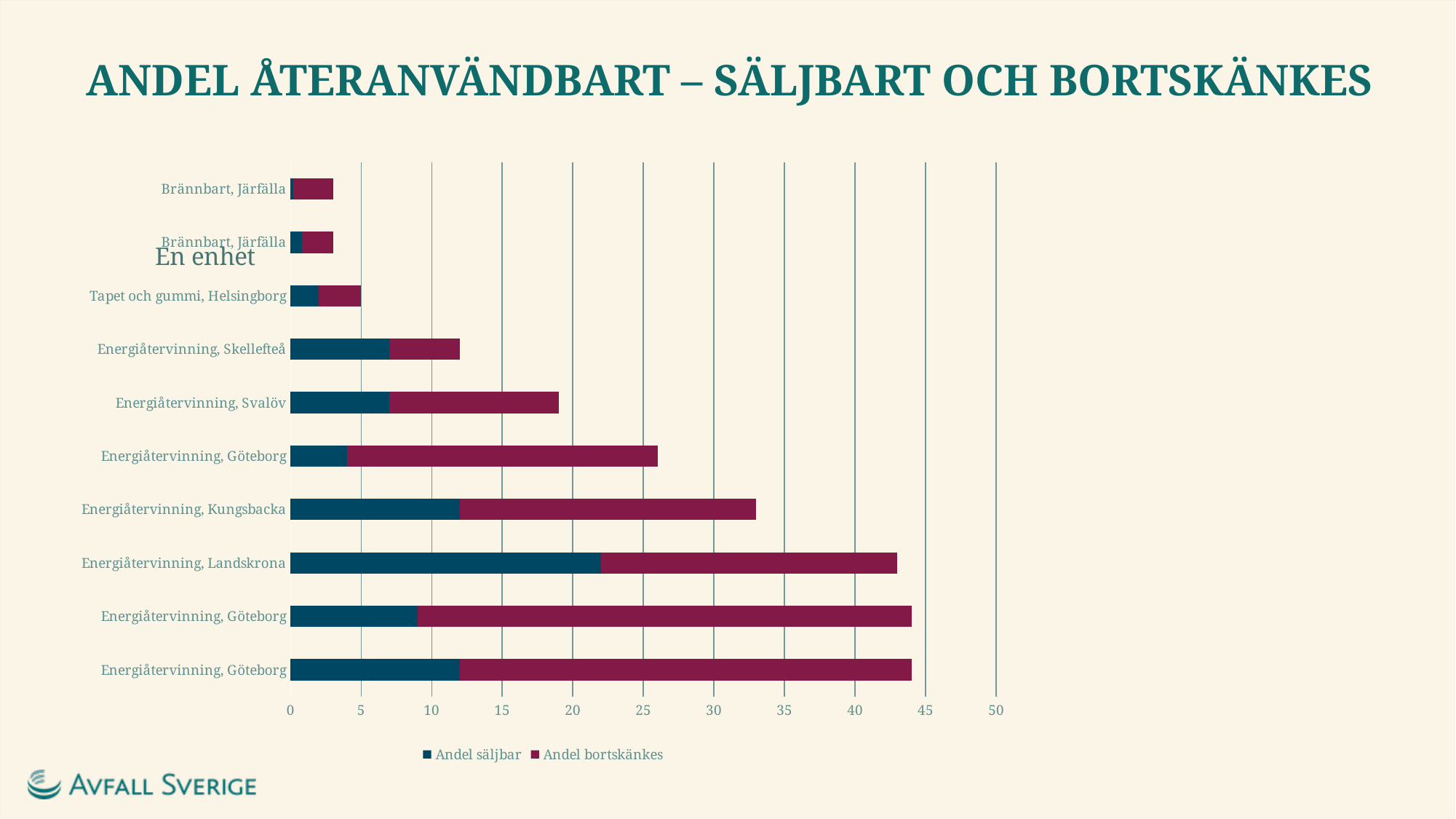
Which category has the longest total bar? Energiåtervinning, Göteborg Is the total bar for Energiåtervinning, Kungsbacka greater or less than 30? greater Which has the larger total bar, Energiåtervinning, Landskrona or Energiåtervinning, Kungsbacka? Energiåtervinning, Landskrona What kind of chart is shown on the slide? bar chart Is the total bar for Energiåtervinning, Svalöv greater or less than 20? less Is the total bar for Energiåtervinning, Skellefteå greater or less than 10? greater Which category has the shortest total bar? Brännbart, Järfälla Which has the larger total bar, Energiåtervinning, Kungsbacka or Energiåtervinning, Svalöv? Energiåtervinning, Kungsbacka What are the two series named in the legend? Andel säljbar and Andel bortskänkes How many bars are plotted in the chart? 10 How many series does the legend list? 2